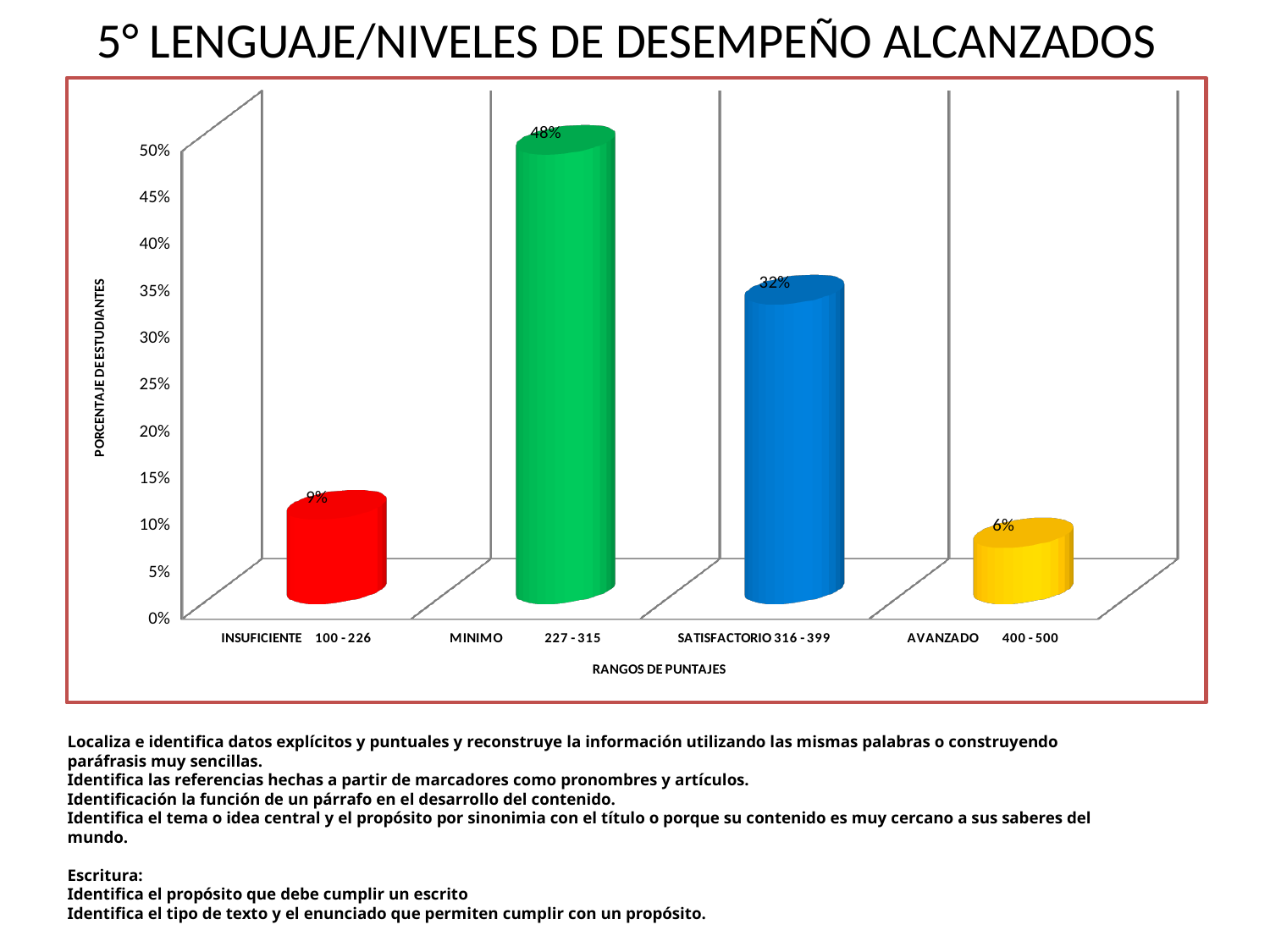
Which category has the lowest percentage of students? AVANZADO 400 - 500 What is the difference in percentage points between the MINIMO and SATISFACTORIO categories? 16 What percentage of students is shown for the SATISFACTORIO (316 - 399) category? 32% Which category has a larger percentage of students, INSUFICIENTE or AVANZADO? INSUFICIENTE Which category has the highest percentage of students? MINIMO 227 - 315 What is the label of the vertical axis of the chart? PORCENTAJE DE ESTUDIANTES What percentage of students is shown for the MINIMO (227 - 315) category? 48% What is the label of the horizontal axis of the chart? RANGOS DE PUNTAJES How many categories are shown on the x axis of the chart? 4 What kind of chart is shown on the slide? Bar chart What percentage of students is shown for the INSUFICIENTE (100 - 226) category? 9% What percentage of students is shown for the AVANZADO (400 - 500) category? 6%